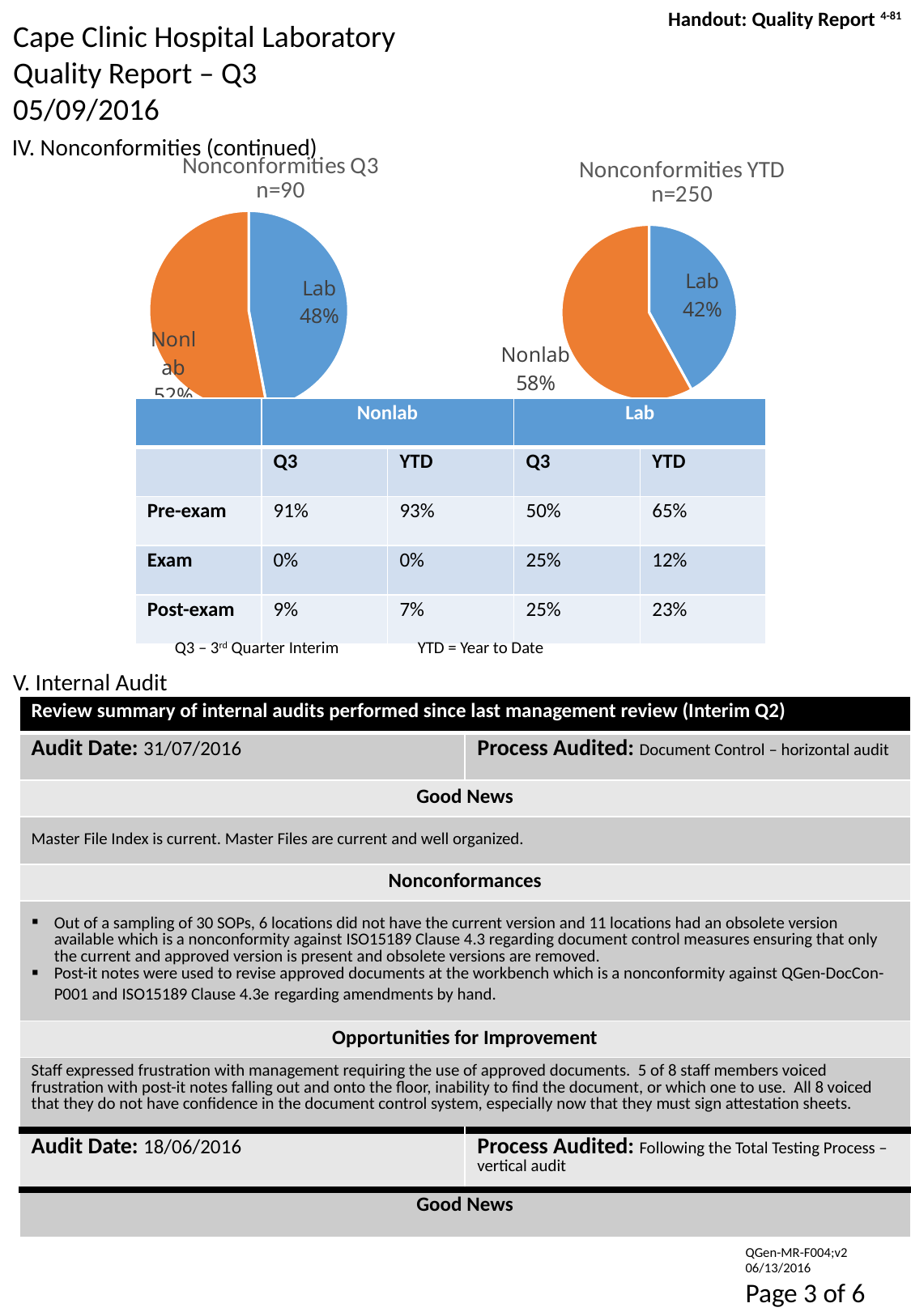
Is the Lab share in the Nonconformities YTD pie chart greater or less than 50%? less In the Nonconformities Q3 pie chart, which slice is larger, Lab or Nonlab? Nonlab What kind of chart is the Nonconformities Q3 chart? Pie chart In the Nonconformities YTD pie chart, what share is labelled for Nonlab? 58% In the Nonconformities YTD pie chart, what is the difference between the Nonlab and Lab shares? 16% Which chart shows the smaller Lab share, Nonconformities Q3 or Nonconformities YTD? Nonconformities YTD What is the n value shown in the title of the Nonconformities Q3 chart? n=90 What is the n value shown in the title of the Nonconformities YTD chart? n=250 In the Nonconformities YTD pie chart, what share is labelled for Lab? 42% In the Nonconformities YTD pie chart, which slice is larger, Lab or Nonlab? Nonlab In the Nonconformities Q3 pie chart, what share is labelled for Lab? 48% How many slices does the Nonconformities YTD pie chart have? 2